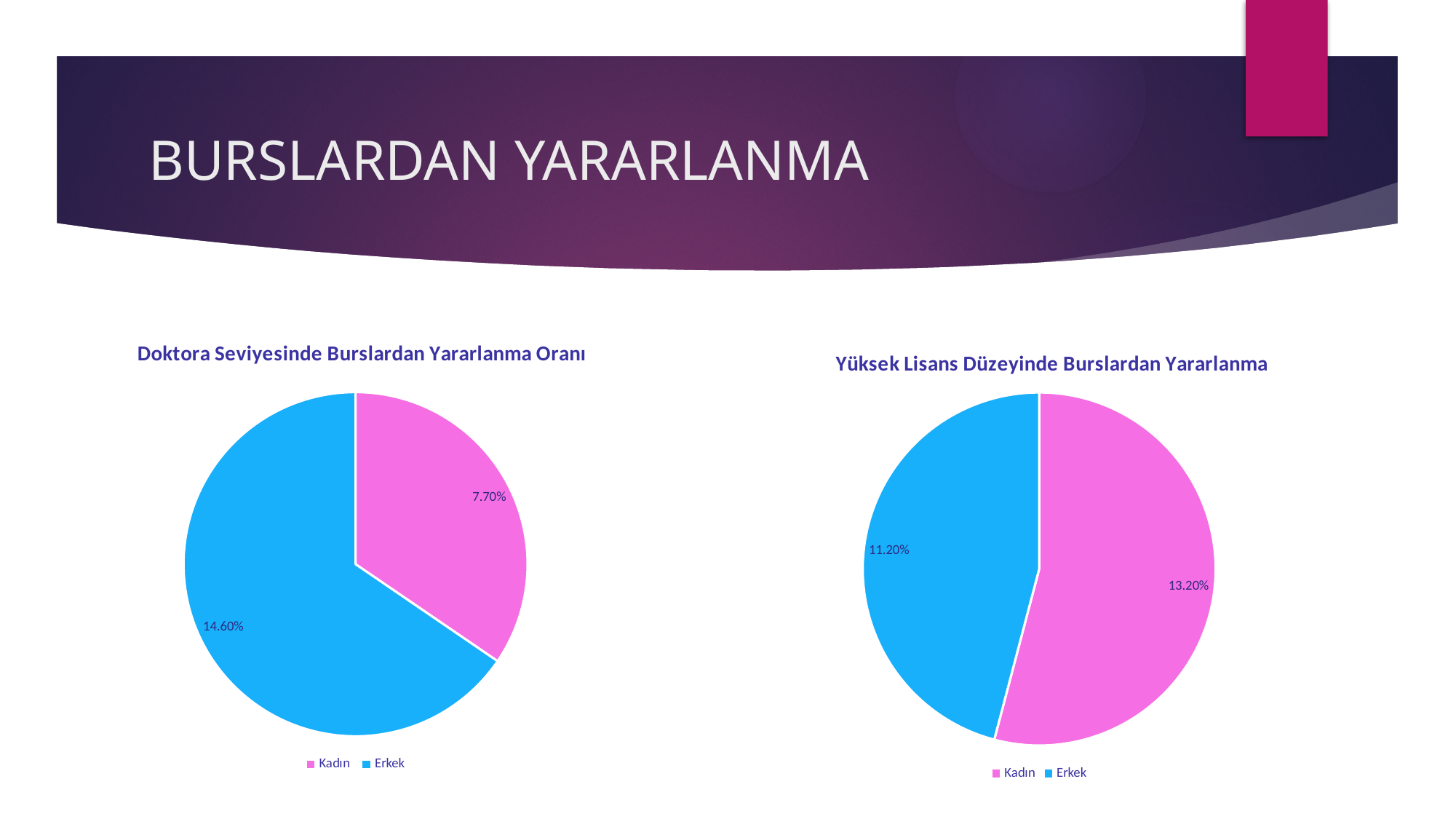
In the chart titled "Doktora Seviyesinde Burslardan Yararlanma Oranı", what is the difference between the Erkek and Kadın values? 6.90% In the right chart (Yüksek Lisans Düzeyinde Burslardan Yararlanma), which is larger, Kadın or Erkek? Kadın In the chart titled "Yüksek Lisans Düzeyinde Burslardan Yararlanma", what is the value for Erkek? 11.20% In the left chart (Doktora Seviyesinde Burslardan Yararlanma Oranı), which category has the largest slice? Erkek In the right chart (Yüksek Lisans Düzeyinde Burslardan Yararlanma), which category has the smallest slice? Erkek In the left chart (Doktora Seviyesinde Burslardan Yararlanma Oranı), what colour is the Erkek slice? Blue How many slices does the left chart (Doktora Seviyesinde Burslardan Yararlanma Oranı) have? 2 What type of chart is the one titled "Yüksek Lisans Düzeyinde Burslardan Yararlanma"? Pie chart In the chart titled "Doktora Seviyesinde Burslardan Yararlanma Oranı", what is the value for Kadın? 7.70% In the chart titled "Yüksek Lisans Düzeyinde Burslardan Yararlanma", what is the difference between the Kadın and Erkek values? 2.00% In the chart titled "Yüksek Lisans Düzeyinde Burslardan Yararlanma", what is the value for Kadın? 13.20% In the chart titled "Doktora Seviyesinde Burslardan Yararlanma Oranı", what is the value for Erkek? 14.60%